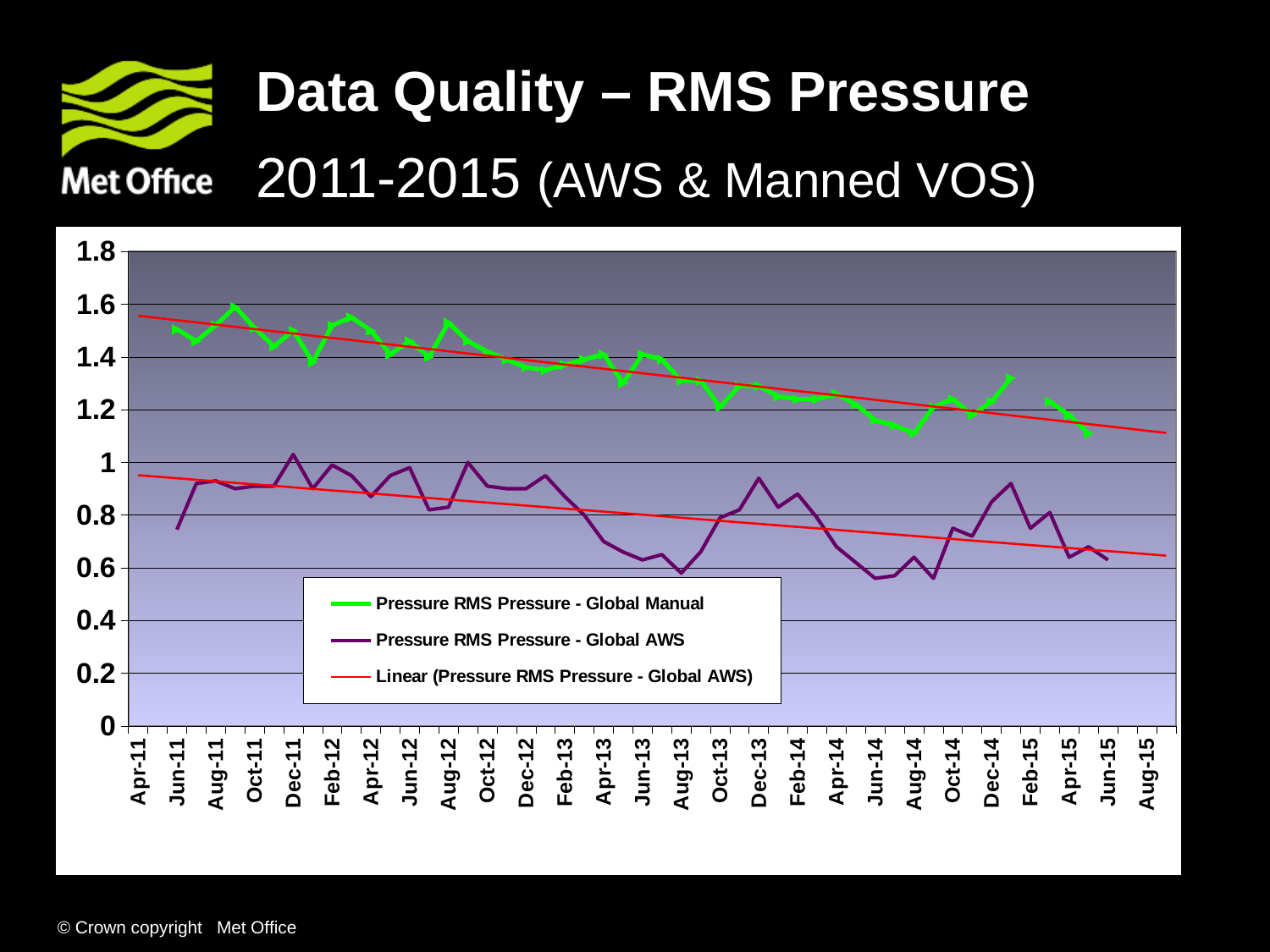
How many entries does the chart legend list? 3 Does the Pressure RMS Pressure - Global Manual series generally rise or fall from Apr-11 to Apr-15? fall What colour is the line for Pressure RMS Pressure - Global Manual in the legend? green Which series has the higher values throughout the chart, Global Manual or Global AWS? Global Manual What is the highest value shown on the vertical axis of the chart? 1.8 Is the value for Pressure RMS Pressure - Global AWS at Dec-13 greater or less than 0.8? greater What kind of chart is shown on the slide? line chart Is the value for Pressure RMS Pressure - Global Manual at Aug-14 greater or less than 1.2? less Is the value for Pressure RMS Pressure - Global AWS at Aug-13 greater or less than 0.8? less Does the Pressure RMS Pressure - Global AWS series generally rise or fall across the period shown? fall